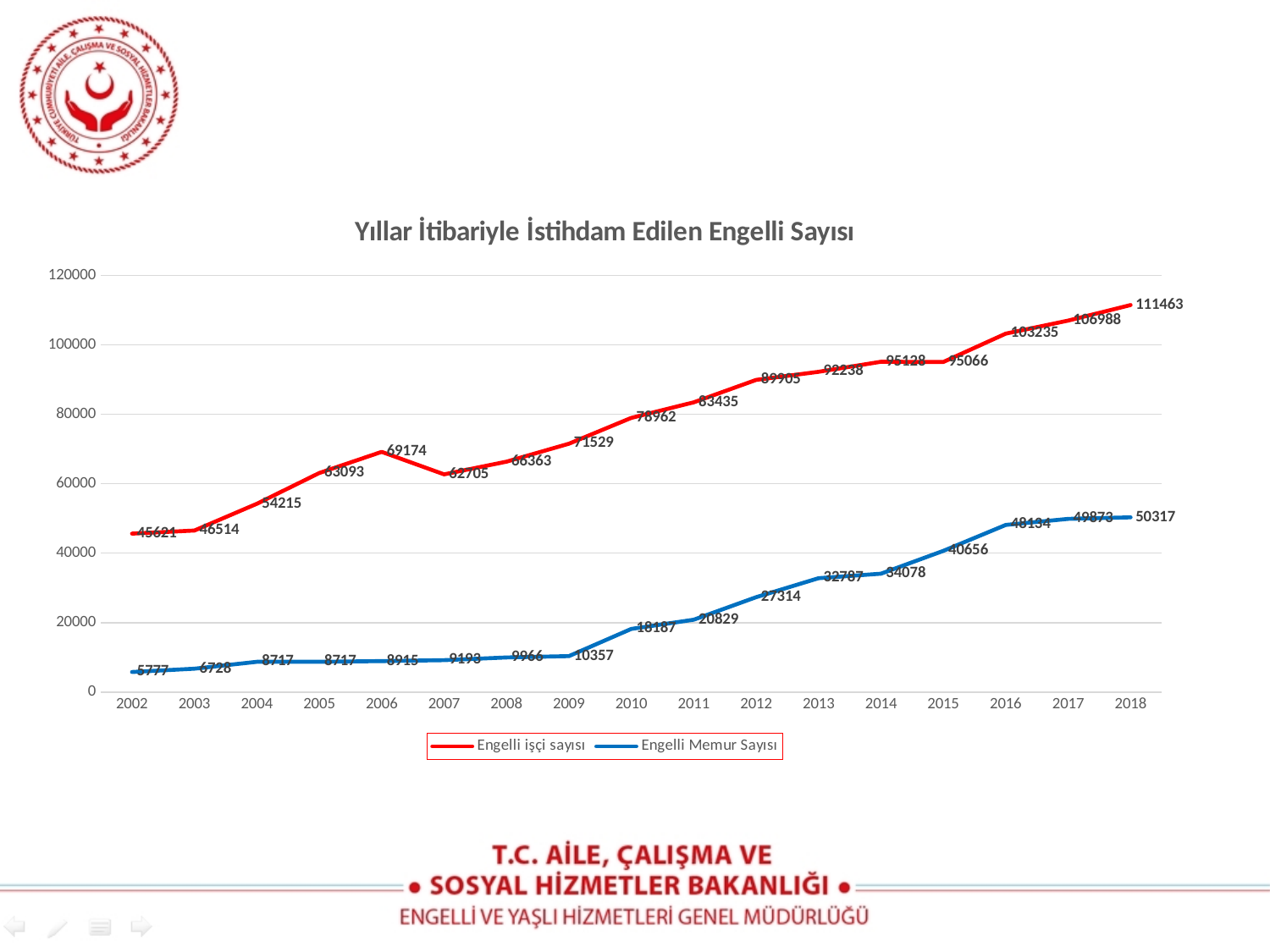
In which year is Engelli işçi sayısı lowest? 2002 Which is larger in 2015: Engelli işçi sayısı or Engelli Memur Sayısı? Engelli işçi sayısı How many series does the legend list? 2 How many years are shown on the x axis? 17 What is the value of Engelli işçi sayısı in 2006? 69174 What is the value of Engelli işçi sayısı in 2018? 111463 Is the value of Engelli Memur Sayısı in 2012 greater or less than 20000? greater What is the title of the chart? Yıllar İtibariyle İstihdam Edilen Engelli Sayısı In which year is Engelli Memur Sayısı highest? 2018 What is the difference between Engelli işçi sayısı in 2018 and in 2017? 4475 What kind of chart is shown on the slide? line chart What is the value of Engelli Memur Sayısı in 2010? 18187